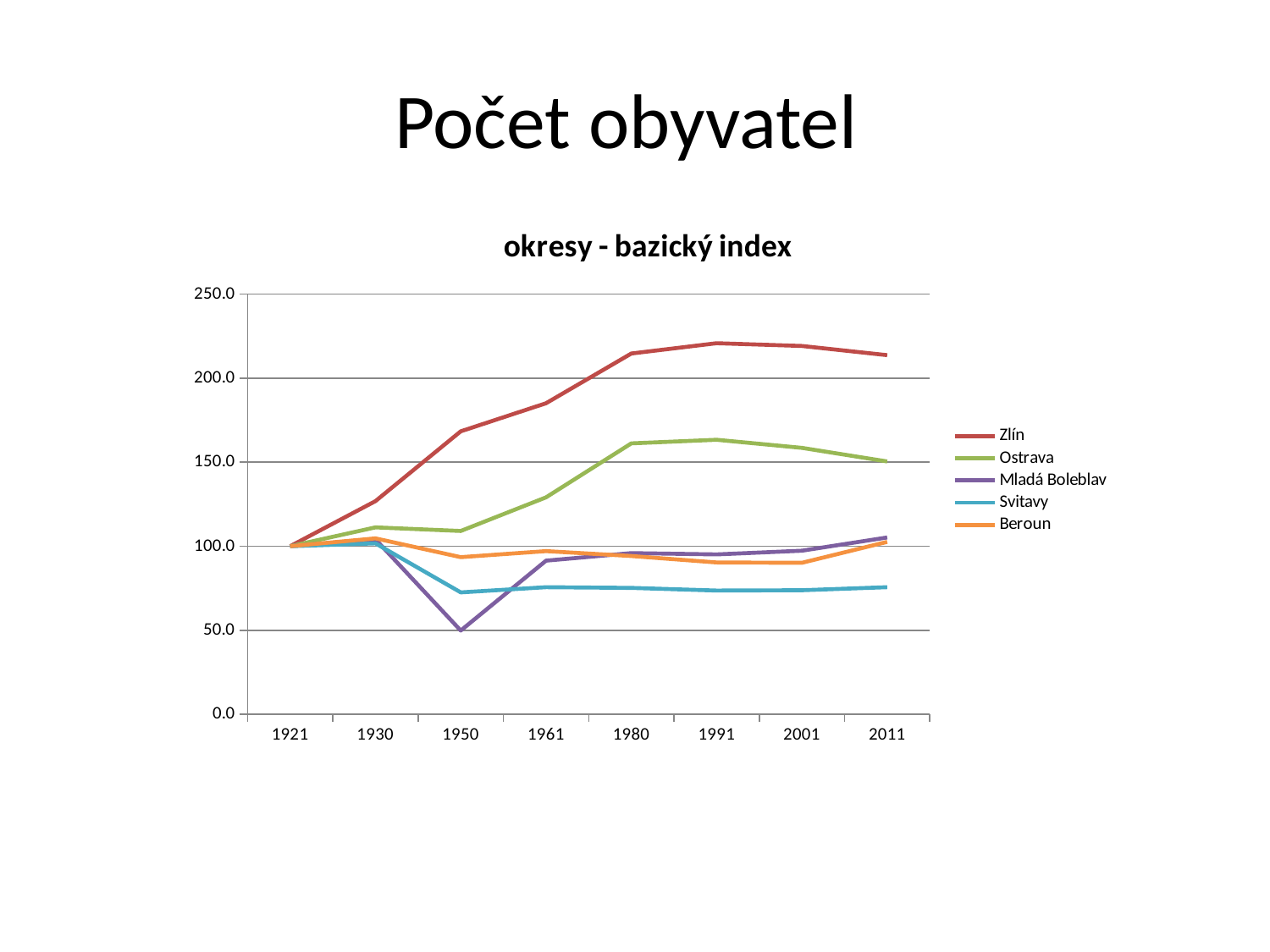
How many years are shown on the x axis? 8 Is the value for Svitavy in 2011 greater or less than 100.0? less Does the Zlín line rise or fall between 1921 and 1980? rise How many series does the legend list? 5 What is the title of the chart? okresy - bazický index Is the value for Ostrava in 1980 greater or less than 150.0? greater What kind of chart is shown on the slide? line chart Which is larger in 2001, the value for Ostrava or the value for Beroun? Ostrava Is the value for Zlín in 1991 greater or less than 200.0? greater What is the value for Beroun in 1921? 100.0 Which series has the highest value in 2011? Zlín Which series has the lowest value in 1950? Mladá Boleblav